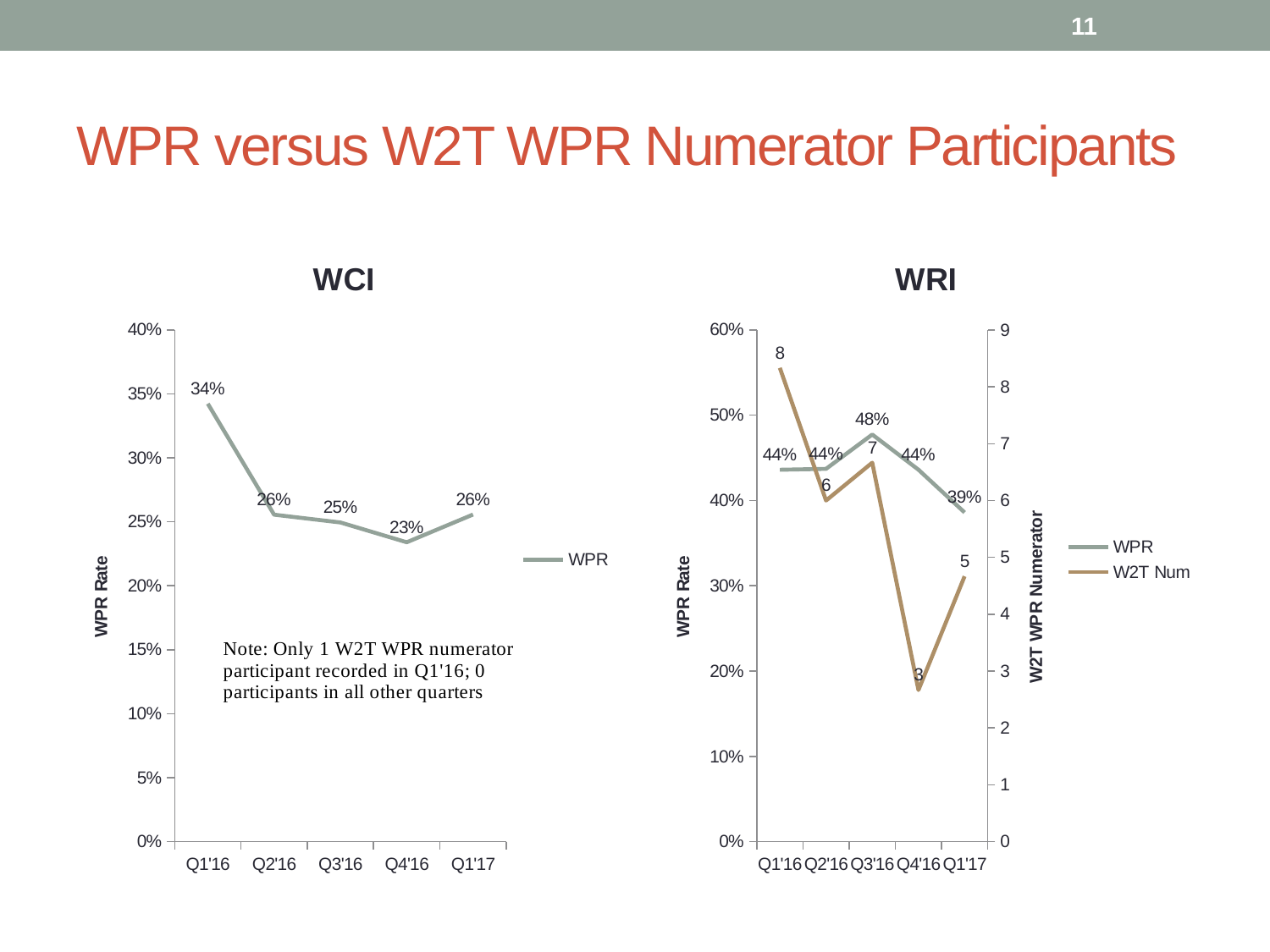
In the WCI chart, which quarter has the highest WPR rate? Q1'16 In the WCI chart, what is the WPR rate for Q1'16? 34% What kind of chart is the WCI chart? Line chart In the WCI chart, what is the WPR rate for Q4'16? 23% In the WCI chart, what is the difference between the WPR rate in Q1'16 and Q2'16? 8% How many series does the legend of the WRI chart list? 2 In the WRI chart, is the W2T Num value larger in Q2'16 or Q1'17? Q2'16 In the WCI chart, which quarter has the lowest WPR rate? Q4'16 In the WRI chart, what is the W2T WPR Numerator value for Q1'16? 8 In the WRI chart, which quarter has the lowest W2T Num value? Q4'16 In the WRI chart, what is the WPR rate for Q3'16? 48% How many quarters are plotted on the x axis of the WCI chart? 5